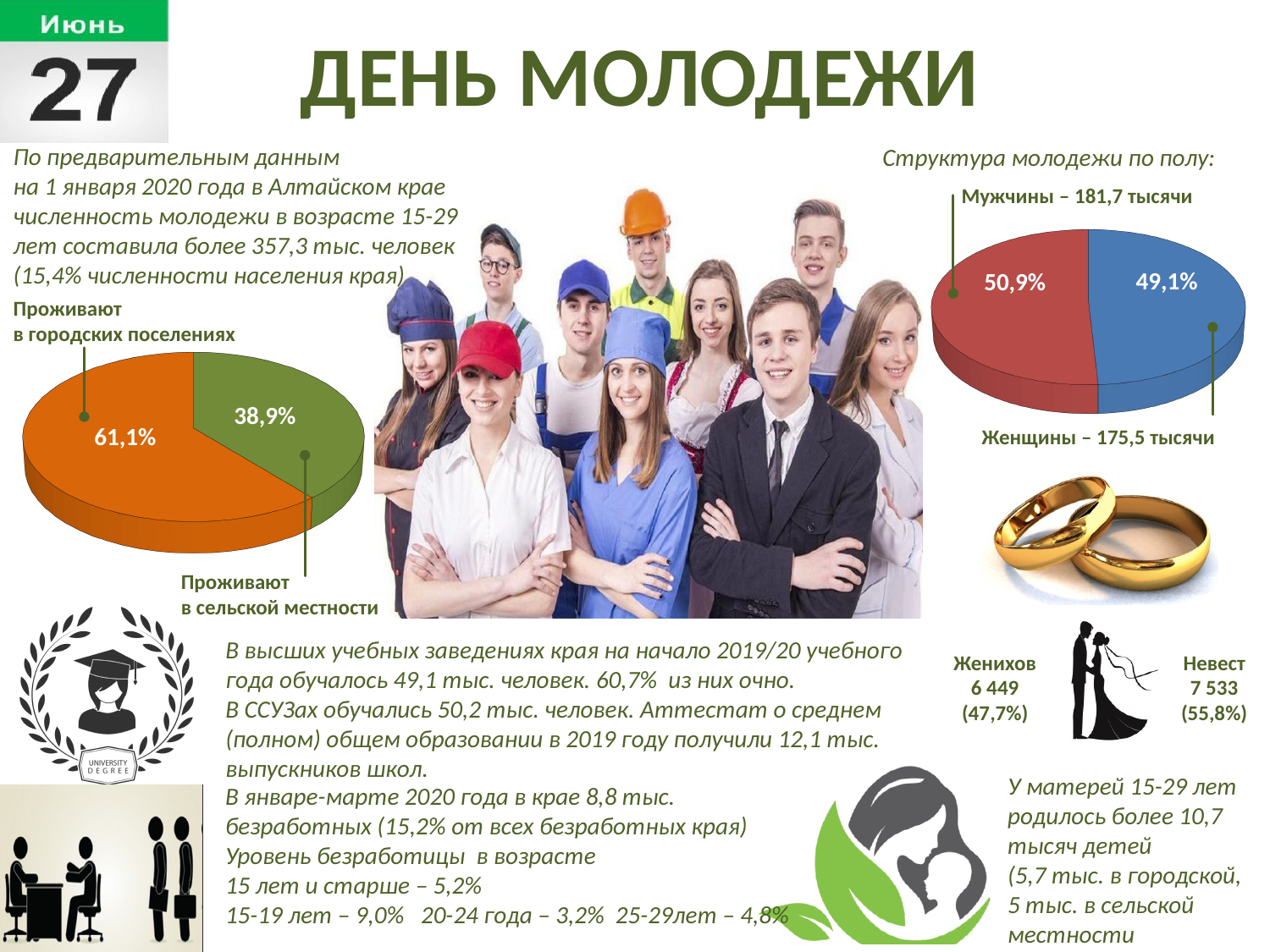
On the right pie chart 'Структура молодежи по полу', what colour is the slice for women (Женщины)? Blue On the left pie chart, what is the difference in percentage points between the urban and rural shares? 22,2 On the left pie chart, what share of young people live in urban settlements (Проживают в городских поселениях)? 61,1% On the right pie chart 'Структура молодежи по полу', what percentage share do men (Мужчины) have? 50,9% On the right pie chart 'Структура молодежи по полу', which group is larger, men or women? Men (Мужчины) On the right pie chart 'Структура молодежи по полу', how many thousand women are there according to the label? 175,5 тысячи On the right pie chart 'Структура молодежи по полу', how many thousand men are there according to the label? 181,7 тысячи On the right pie chart 'Структура молодежи по полу', what percentage share do women (Женщины) have? 49,1% On the left pie chart, which group is larger: those living in urban settlements or those living in rural areas? Urban settlements (Проживают в городских поселениях) On the left pie chart, what share of young people live in rural areas (Проживают в сельской местности)? 38,9% How many slices does the left pie chart have? 2 What type of chart is used on the left side of the slide to show urban versus rural residence? Pie chart